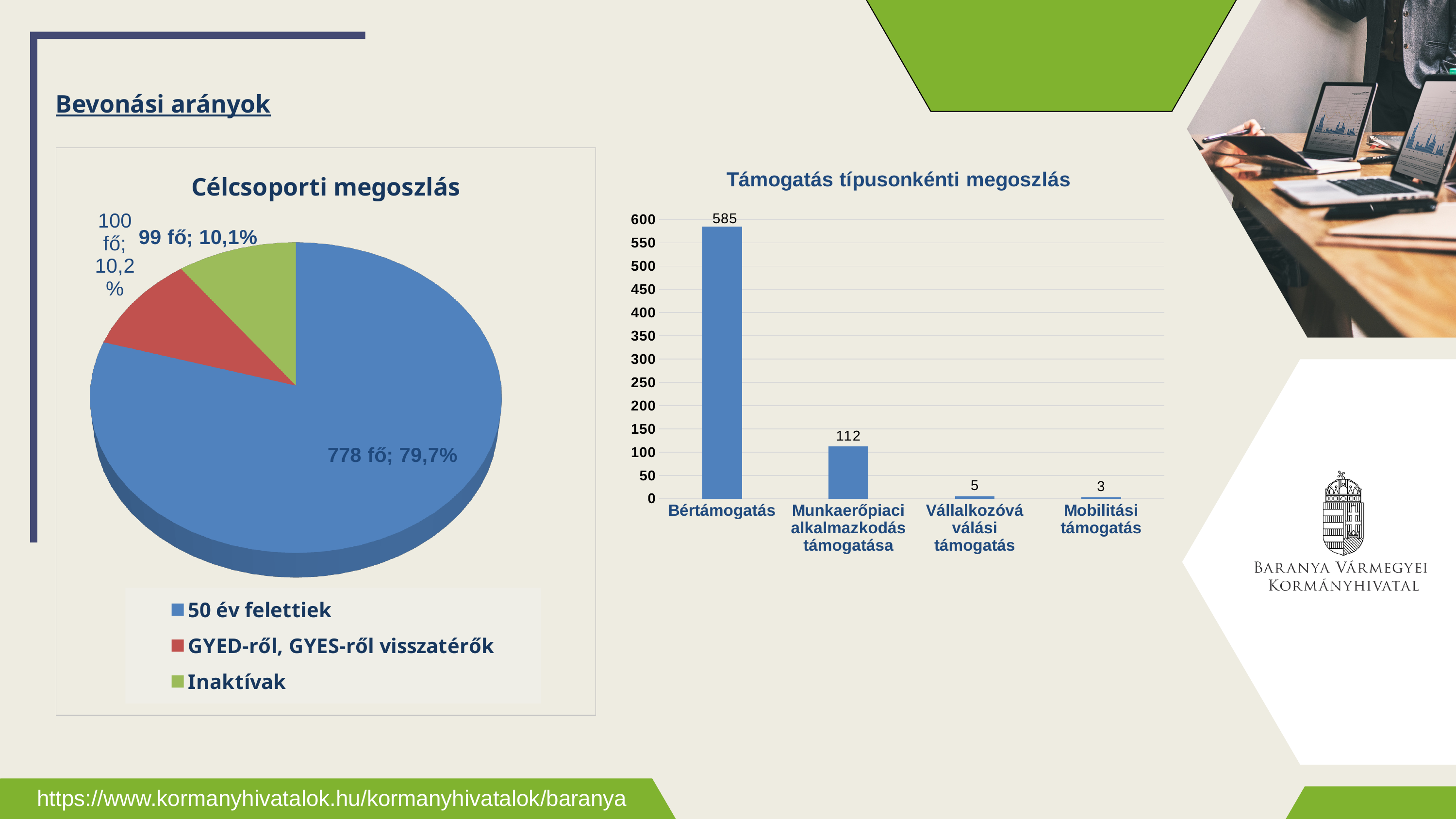
In the chart 'Támogatás típusonkénti megoszlás', what is the value for 'Munkaerőpiaci alkalmazkodás támogatása'? 112 In the pie chart 'Célcsoporti megoszlás', what share of the pie does '50 év felettiek' have? 79,7% In the chart 'Támogatás típusonkénti megoszlás', which is larger: 'Vállalkozóvá válási támogatás' or 'Mobilitási támogatás'? Vállalkozóvá válási támogatás In the pie chart 'Célcsoporti megoszlás', what value is shown for '50 év felettiek'? 778 fő; 79,7% What kind of chart is 'Célcsoporti megoszlás'? Pie chart What kind of chart is 'Támogatás típusonkénti megoszlás'? Bar chart In the pie chart 'Célcsoporti megoszlás', which category has the largest slice? 50 év felettiek In the pie chart 'Célcsoporti megoszlás', what colour is the slice for 'Inaktívak'? Green In the chart 'Támogatás típusonkénti megoszlás', what is the difference between 'Bértámogatás' and 'Munkaerőpiaci alkalmazkodás támogatása'? 473 How many categories does the legend of the pie chart 'Célcsoporti megoszlás' list? 3 In the chart 'Támogatás típusonkénti megoszlás', what is the value for 'Bértámogatás'? 585 In the chart 'Támogatás típusonkénti megoszlás', which category has the lowest value? Mobilitási támogatás